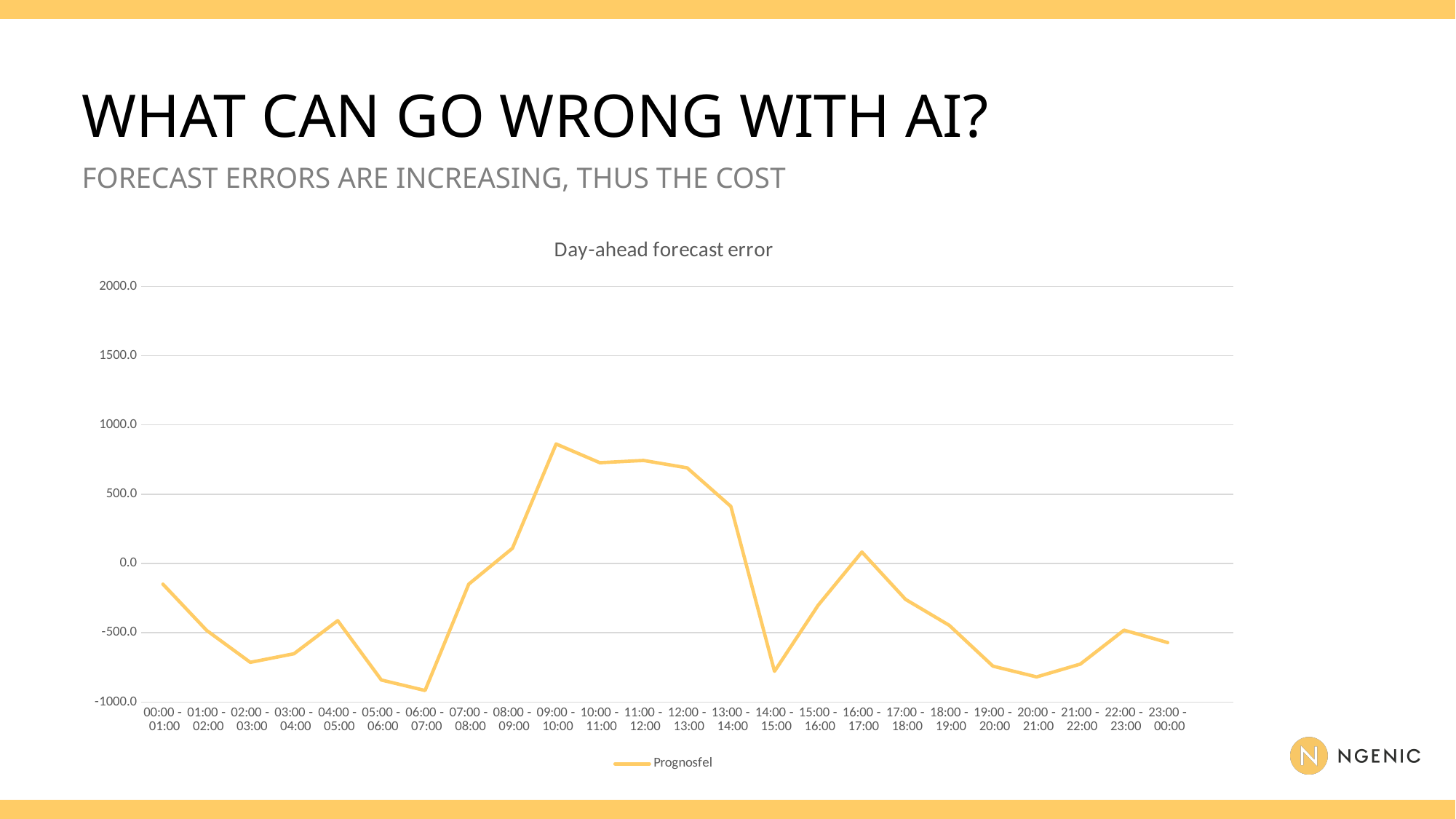
How many hourly intervals are plotted along the x axis? 24 What kind of chart is shown on the slide? line chart Do the values rise or fall from 09:00 - 10:00 to 14:00 - 15:00? fall Which is larger, the value for 09:00 - 10:00 or the value for 13:00 - 14:00? 09:00 - 10:00 Is the value for 13:00 - 14:00 greater or less than 0.0? greater What is the name of the series shown in the legend? Prognosfel Which hourly interval has the lowest forecast error? 06:00 - 07:00 How many series does the legend list? 1 What is the title of the chart? Day-ahead forecast error Which hourly interval has the highest forecast error? 09:00 - 10:00 Is the value for 06:00 - 07:00 greater or less than -500.0? less Is the value for 09:00 - 10:00 greater or less than 500.0? greater